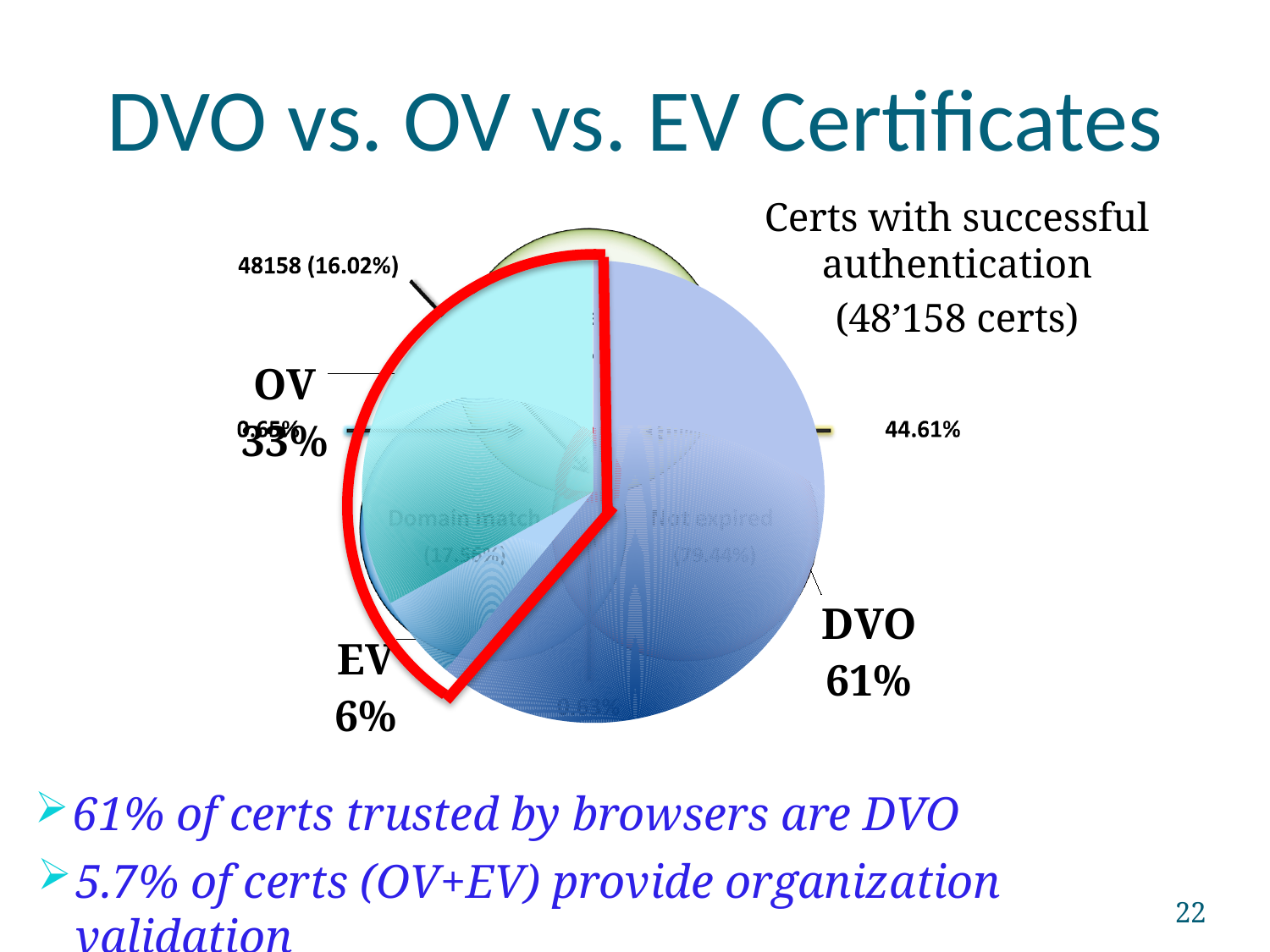
How many certificate types are labelled on the pie chart? 3 What is the difference in percentage points between the OV slice and the EV slice? 27% Which certificate type has the largest slice of the pie chart? DVO What share of the pie chart is labelled EV? 6% Which certificate type has the smallest slice of the pie chart? EV What kind of chart is shown on the slide? Pie chart What is the difference in percentage points between the DVO slice and the OV slice? 28% Which slice is larger, DVO or OV? DVO What share of the pie chart is labelled OV? 33% What share of the pie chart is labelled DVO? 61% Which slice is larger, OV or EV? OV According to the text next to the chart, how many certs had successful authentication? 48'158 certs